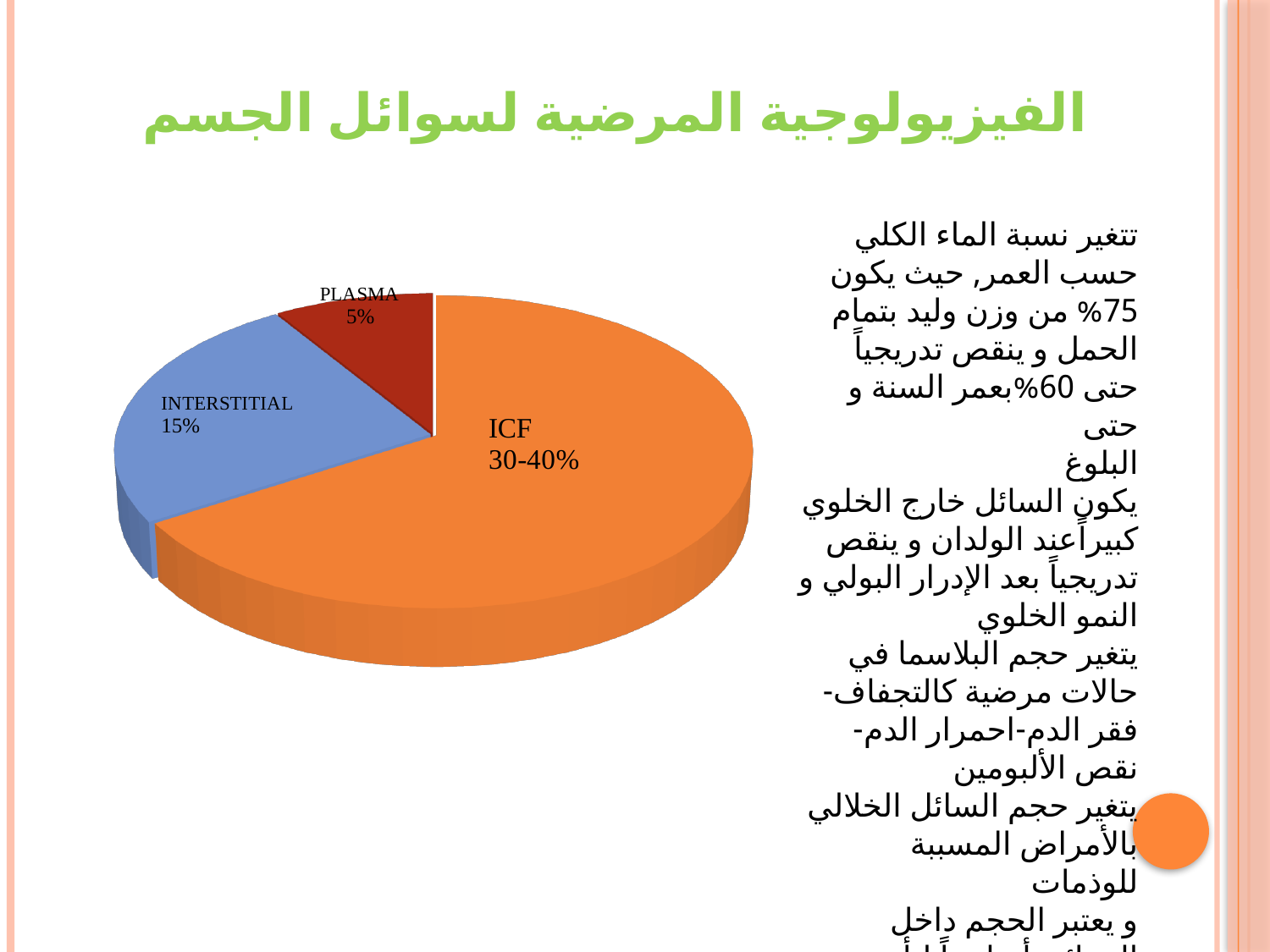
How many slices does the pie chart have? 3 Which is larger, the INTERSTITIAL slice or the PLASMA slice? INTERSTITIAL What colour is the INTERSTITIAL slice? blue What value is shown for the INTERSTITIAL slice? 15% What value is shown for the PLASMA slice? 5% What is the difference between the INTERSTITIAL value and the PLASMA value? 10% What type of chart is shown on the slide? pie chart Which slice of the pie chart is the largest? ICF What value is shown for the ICF slice? 30-40% Which slice of the pie chart is the smallest? PLASMA What colour is the ICF slice? orange What share of the pie is labelled for PLASMA? 5%